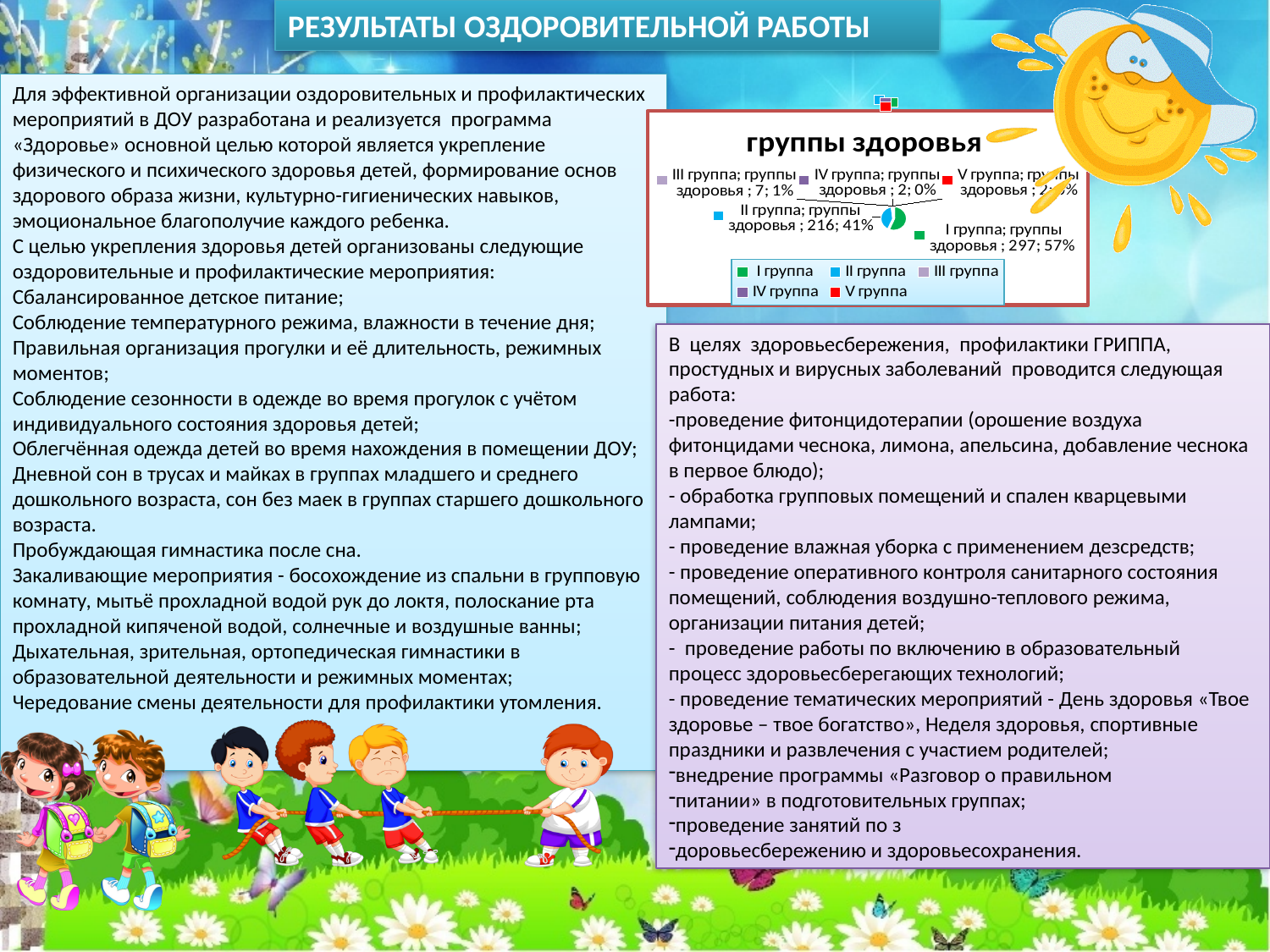
How many categories does the chart's legend list? 5 What is the difference between the values for I группа and II группа? 81 What is the value for III группа in the chart? 7 What share of the pie does II группа take? 41% What is the value for II группа in the chart? 216 What is the title of the chart? группы здоровья What share of the pie does I группа take? 57% Which is larger, the value for I группа or II группа? I группа What kind of chart is shown on the slide? pie chart Which group has the largest slice of the pie? I группа What is the value for IV группа in the chart? 2 What is the value for I группа in the chart? 297